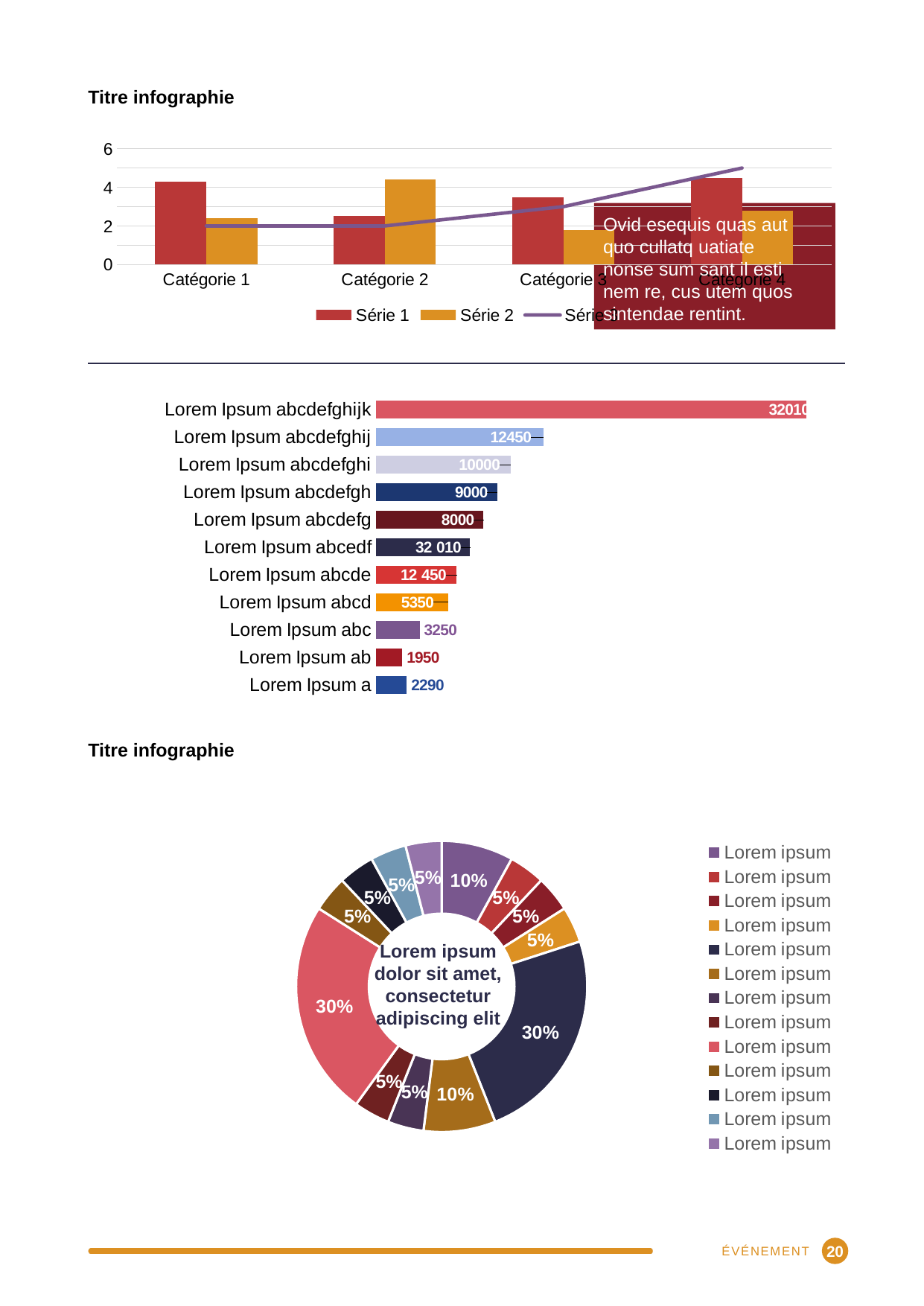
In the middle horizontal bar chart, what is the difference between the values for Lorem Ipsum abcdefgh and Lorem Ipsum abcdefg? 1000 In the top chart, how many categories are shown on the x axis? 4 In the middle horizontal bar chart, what is the value for Lorem Ipsum abcd? 5350 In the bottom donut chart, how many entries does the legend list? 13 In the top chart, does the Série 3 line rise or fall from Catégorie 2 to Catégorie 4? rises In the middle horizontal bar chart, which is larger: the value for Lorem Ipsum a or Lorem Ipsum ab? Lorem Ipsum a In the middle horizontal bar chart, how many categories are listed? 11 In the top chart, is the value of Série 2 for Catégorie 2 greater or less than 4? greater What kind of chart is the top chart titled 'Titre infographie'? Combined bar and line chart In the top chart, is the value of Série 1 for Catégorie 3 greater or less than 4? less In the middle horizontal bar chart, which category has the lowest value? Lorem Ipsum ab In the middle horizontal bar chart, what is the value for Lorem Ipsum abcdefghij? 12450